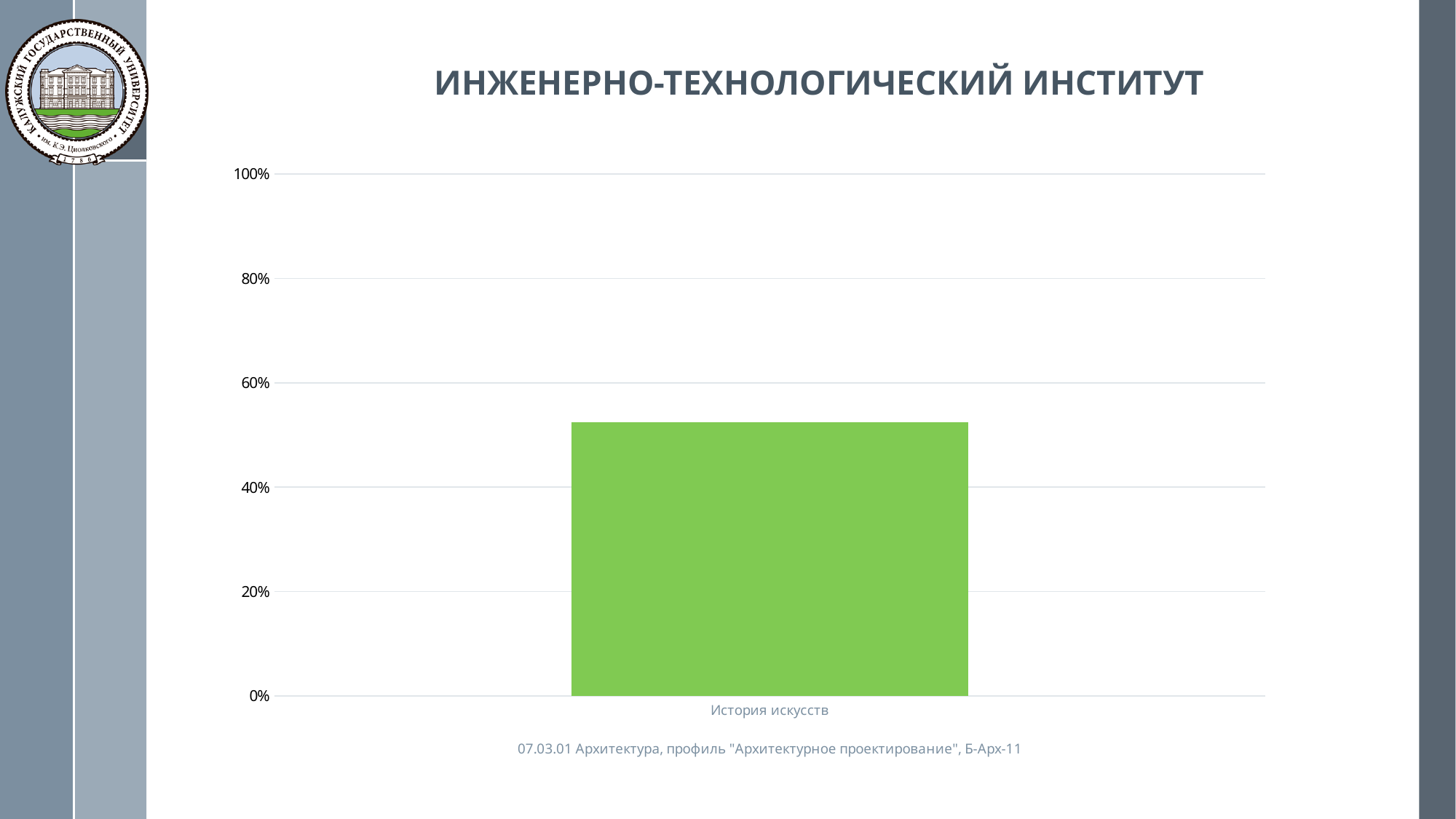
Is the value for История искусств greater or less than 40%? greater Is the value for История искусств greater or less than 20%? greater What kind of chart is shown on the slide? bar chart What is the highest value shown on the vertical axis? 100% Is the value for История искусств greater or less than 80%? less Which category has the highest value on the chart? История искусств How many categories are plotted on the chart? 1 What is the label of the single category on the x axis? История искусств